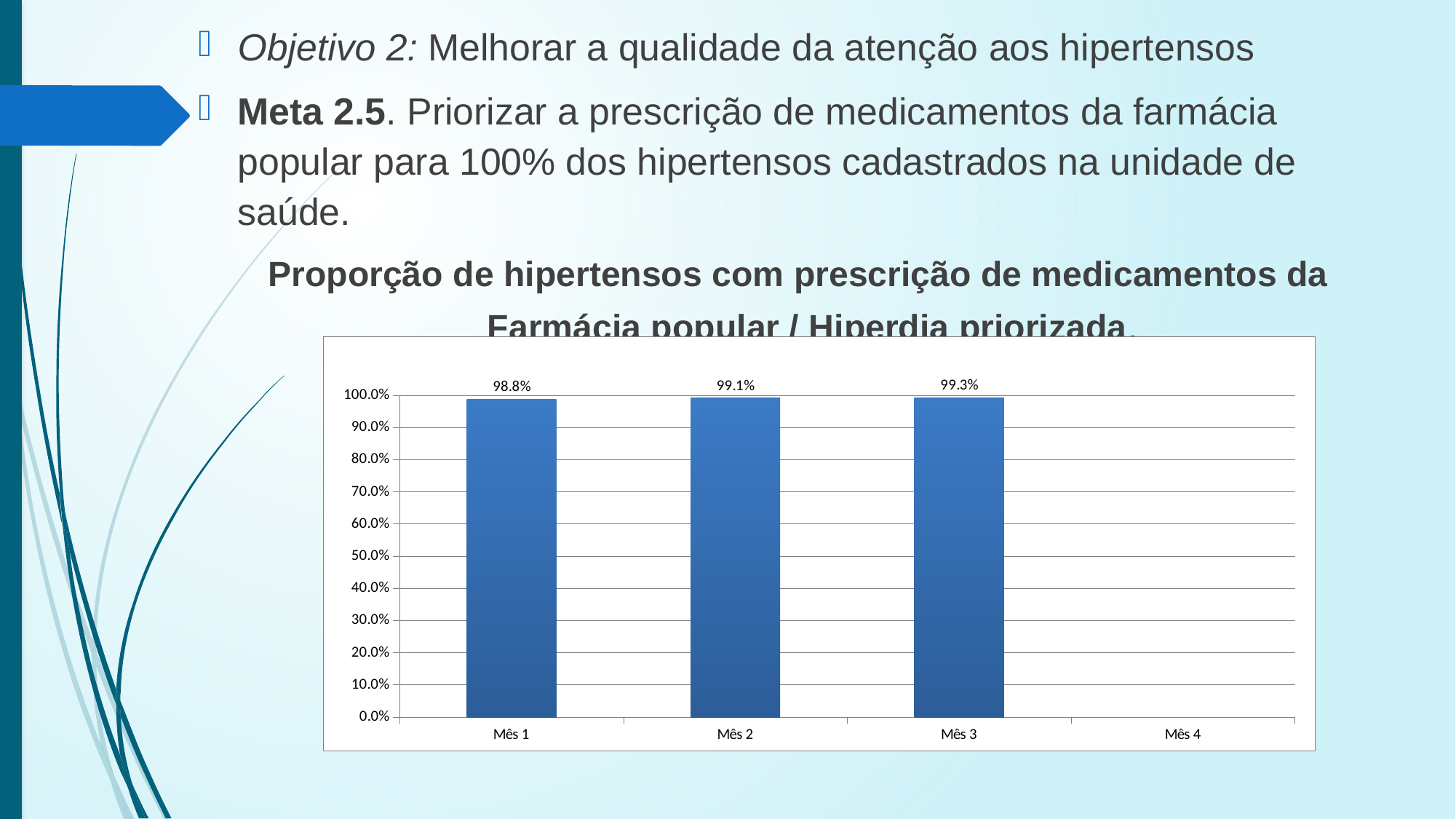
Which month has the highest value shown on the chart? Mês 3 Among the months with a plotted bar, which has the lowest value? Mês 1 What is the value for Mês 2? 99.1% What is the value for Mês 1? 98.8% What is the difference between the values for Mês 3 and Mês 1? 0.5 percentage points How many month categories are shown on the x axis? 4 What is the value for Mês 3? 99.3% What is the difference between the values for Mês 2 and Mês 1? 0.3 percentage points Which is larger, the value for Mês 2 or the value for Mês 3? Mês 3 Do the values rise or fall from Mês 1 to Mês 3? Rise What kind of chart is shown on the slide? Bar chart How many bars are plotted on the chart? 3